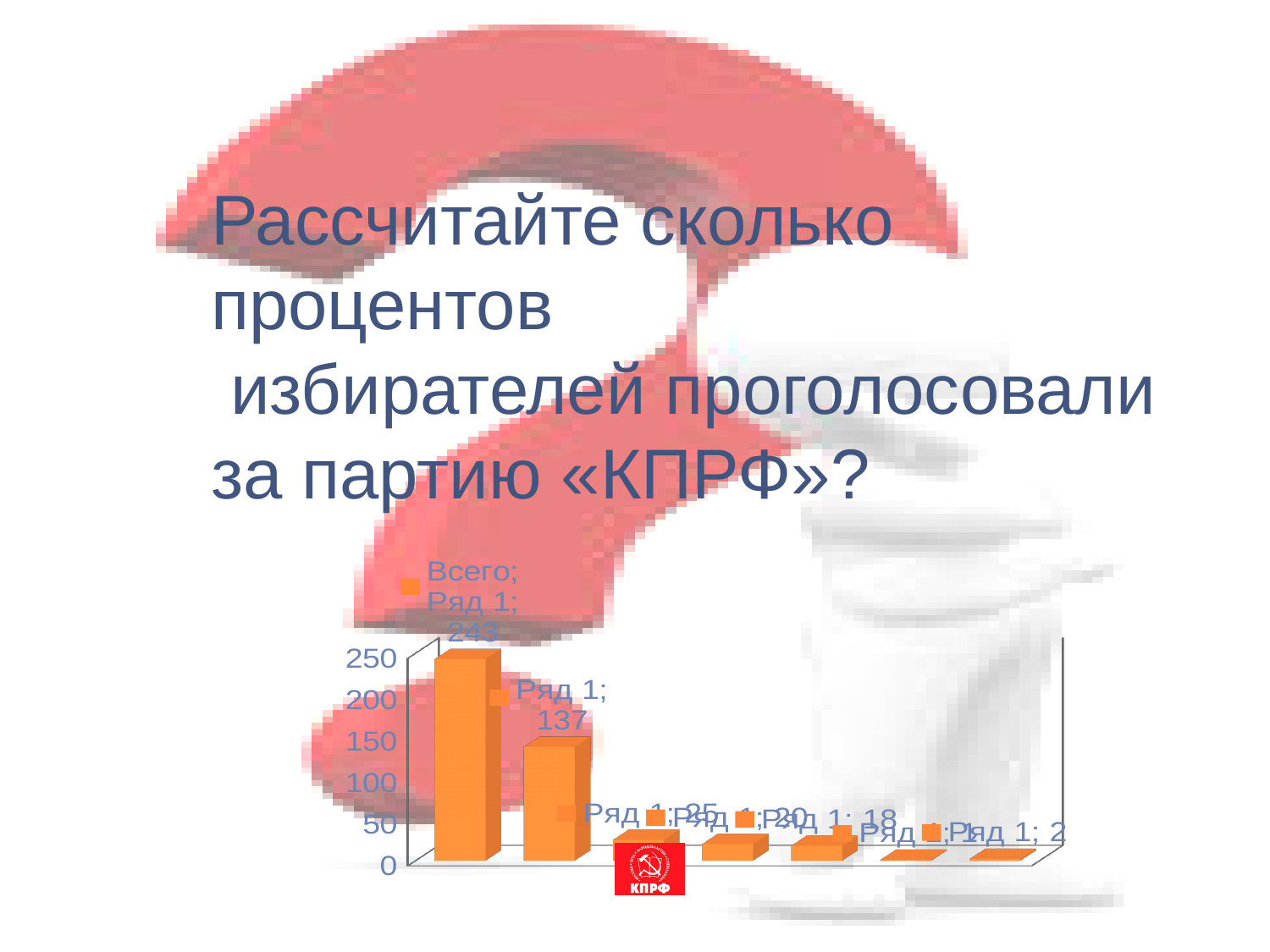
What kind of chart is shown on the slide? bar chart Is the value of the second bar from the left greater or less than 100? greater What is the value of the second bar from the left? 137 What is the value of the bar labelled "Всего"? 243 What is the value of the fifth bar from the left? 18 What is the value of the fourth bar from the left? 20 What series name appears in the data labels of the chart? Ряд 1 How many bars are plotted in the chart? 7 Which is larger, the "Всего" bar or the second bar from the left? Всего Which bar has the highest value? Всего What is the value of the bar above the КПРФ logo (third bar from the left)? 25 What is the difference between the "Всего" bar (243) and the second bar (137)? 106